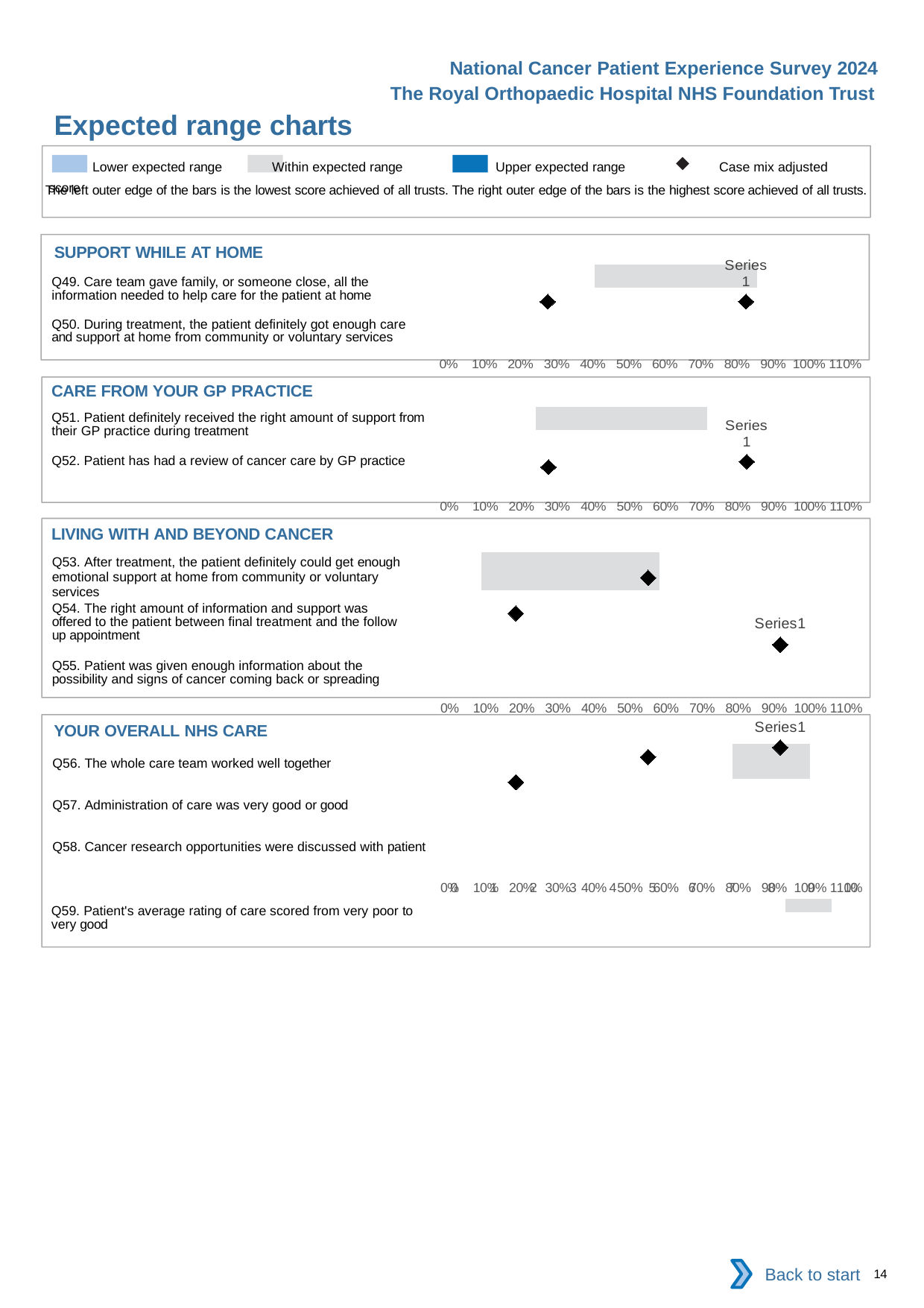
What symbol does the legend use for the case mix adjusted score? A black diamond In the LIVING WITH AND BEYOND CANCER chart, is the diamond marker labelled Series1 greater or less than 80%? greater What is the highest percentage tick shown on the x axis of the CARE FROM YOUR GP PRACTICE chart? 110% In the CARE FROM YOUR GP PRACTICE chart, is the leftmost diamond marker greater or less than 40%? less In the SUPPORT WHILE AT HOME chart, is the rightmost diamond marker greater or less than 70%? greater How many questions are listed in the LIVING WITH AND BEYOND CANCER chart? 3 How many questions are listed in the YOUR OVERALL NHS CARE chart? 4 How many entries does the legend at the top of the slide list? 4 What is the title of the slide containing the charts? Expected range charts How many questions are listed in the SUPPORT WHILE AT HOME chart? 2